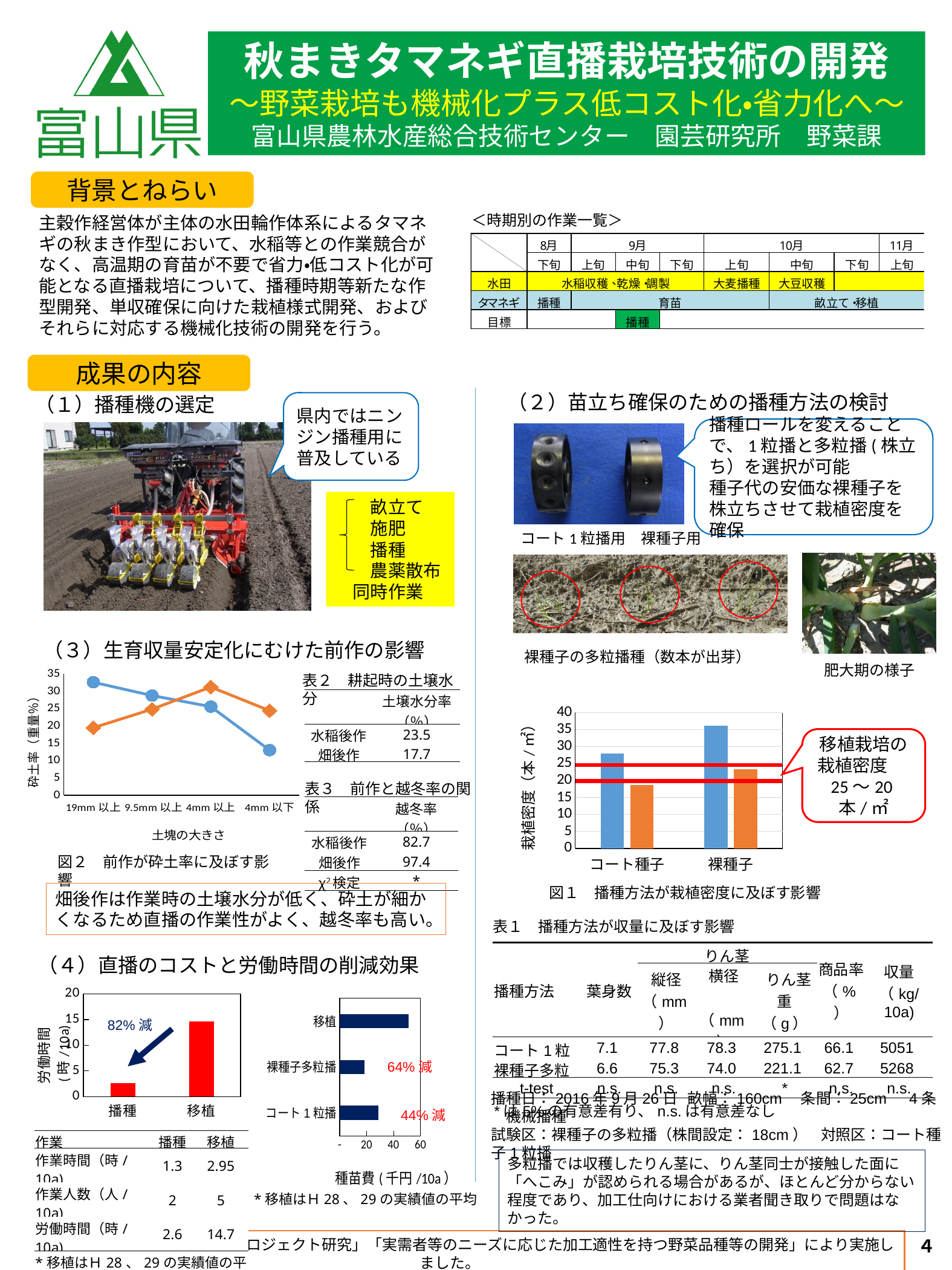
In the 労働時間 bar chart in section (4), which category has the higher bar, 播種 or 移植? 移植 In 図1 播種方法が栽植密度に及ぼす影響, is the blue bar for 裸種子 greater or less than 30? greater In 図2 前作が砕土率に及ぼす影響, how many categories are on the x axis (土塊の大きさ)? 4 What kind of chart is 図1 播種方法が栽植密度に及ぼす影響? bar chart What kind of chart is 図2 前作が砕土率に及ぼす影響? line chart In the 種苗費 horizontal bar chart in section (4), which category has the longest bar? 移植 In 図2 前作が砕土率に及ぼす影響, is the blue value at 19mm以上 greater or less than 30? greater In 図1 播種方法が栽植密度に及ぼす影響, how many categories are shown on the x axis? 2 In 図1 播種方法が栽植密度に及ぼす影響, which category has the taller blue bar? 裸種子 In 図1 播種方法が栽植密度に及ぼす影響, is the orange bar for コート種子 greater or less than 25? less In 図2 前作が砕土率に及ぼす影響, does the blue line rise or fall from 19mm以上 to 4mm以下? fall